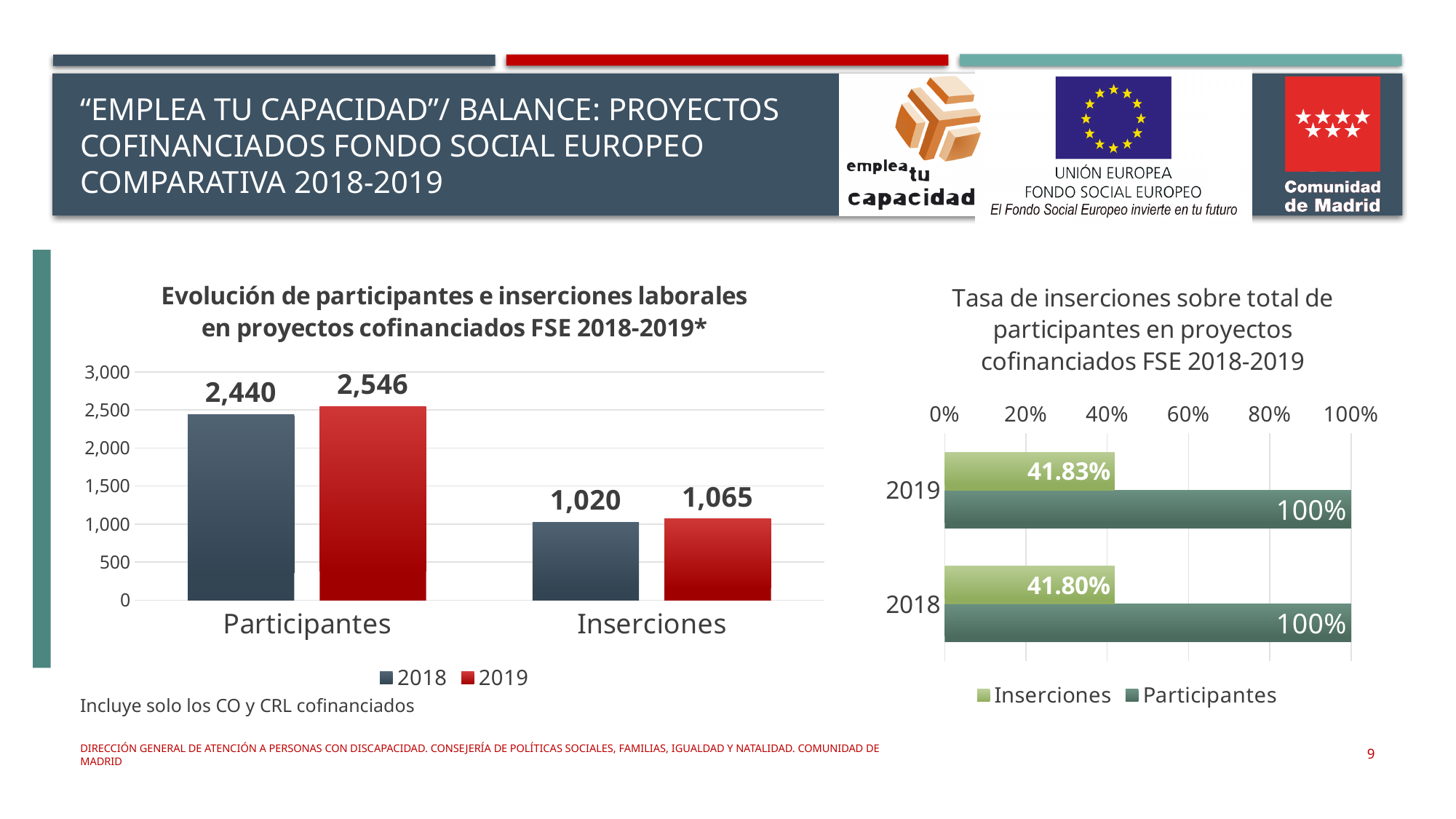
In the right chart 'Tasa de inserciones sobre total de participantes', is the value for Inserciones in 2019 greater or less than 60%? less In the left chart 'Evolución de participantes e inserciones laborales', what is the value for Participantes in 2019? 2,546 In the left chart 'Evolución de participantes e inserciones laborales', what is the difference between Participantes in 2019 and Participantes in 2018? 106 In the right chart 'Tasa de inserciones sobre total de participantes', what is the value for Inserciones in 2018? 41.80% In the left chart 'Evolución de participantes e inserciones laborales', how many series does the legend list? 2 In the right chart 'Tasa de inserciones sobre total de participantes', how many series does the legend list? 2 What kind of chart is the left chart 'Evolución de participantes e inserciones laborales'? Bar chart In the left chart 'Evolución de participantes e inserciones laborales', what is the value for Inserciones in 2018? 1,020 In the left chart 'Evolución de participantes e inserciones laborales', what is the difference between Inserciones in 2019 and Inserciones in 2018? 45 In the right chart 'Tasa de inserciones sobre total de participantes', what is the value for Inserciones in 2019? 41.83% In the right chart 'Tasa de inserciones sobre total de participantes', what is the value for Participantes in 2019? 100% In the left chart 'Evolución de participantes e inserciones laborales', which is larger: Inserciones in 2018 or Inserciones in 2019? Inserciones in 2019